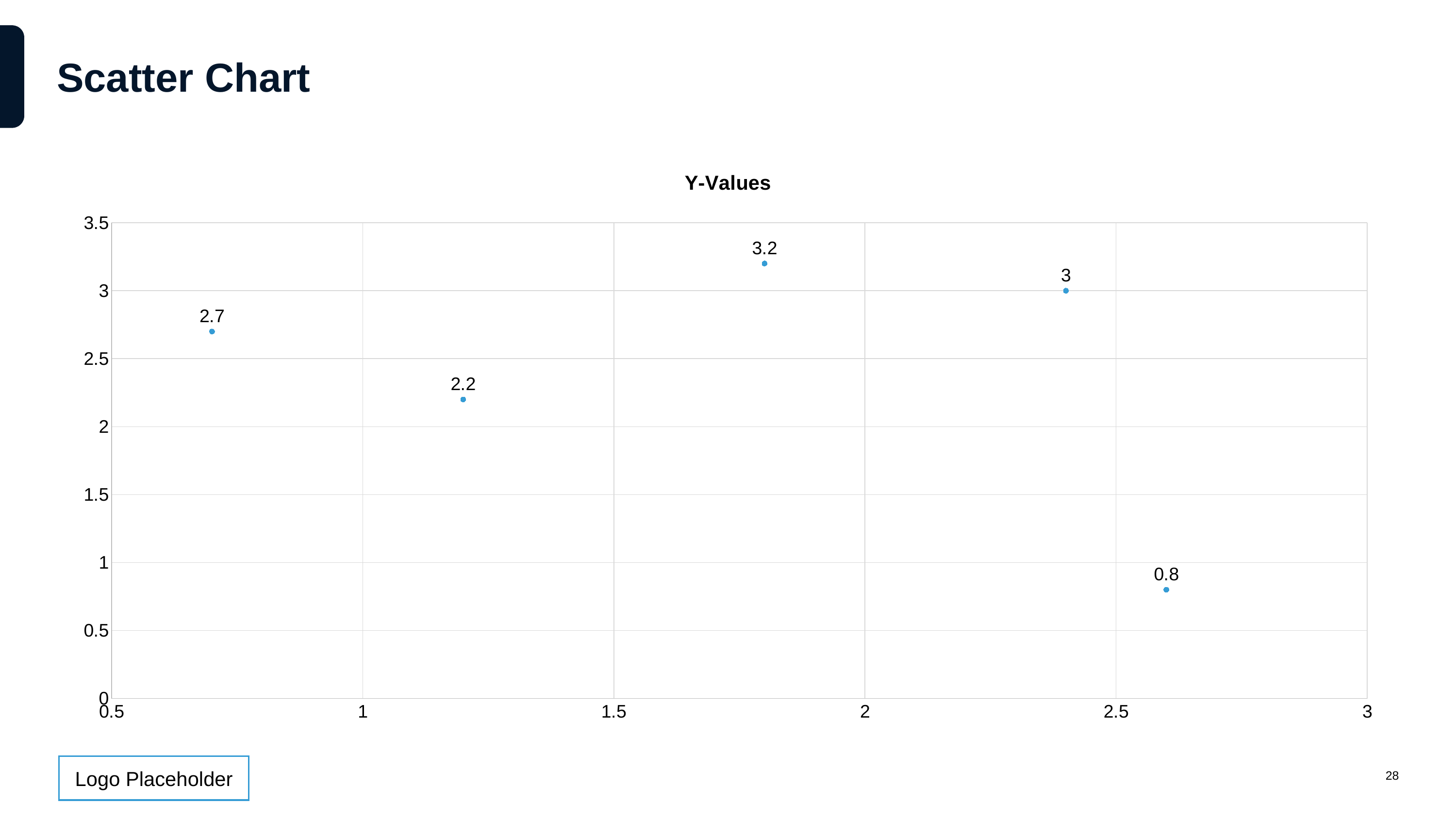
Which is larger, the value of the leftmost point or the value of the second point from the left? the leftmost point (2.7) What is the lowest labelled value on the chart? 0.8 What is the title of the chart? Y-Values What is the difference between the point labelled 3 and the point labelled 2.2? 0.8 What is the difference between the highest labelled value (3.2) and the lowest labelled value (0.8)? 2.4 How many points have a labelled value greater than 2.5? 3 What kind of chart is shown on the slide? scatter chart What is the highest labelled value on the chart? 3.2 What is the labelled value of the rightmost point on the chart? 0.8 What is the labelled value of the leftmost point on the chart? 2.7 How many data points are plotted on the chart? 5 Is the x-axis position of the leftmost point greater or less than 1? less